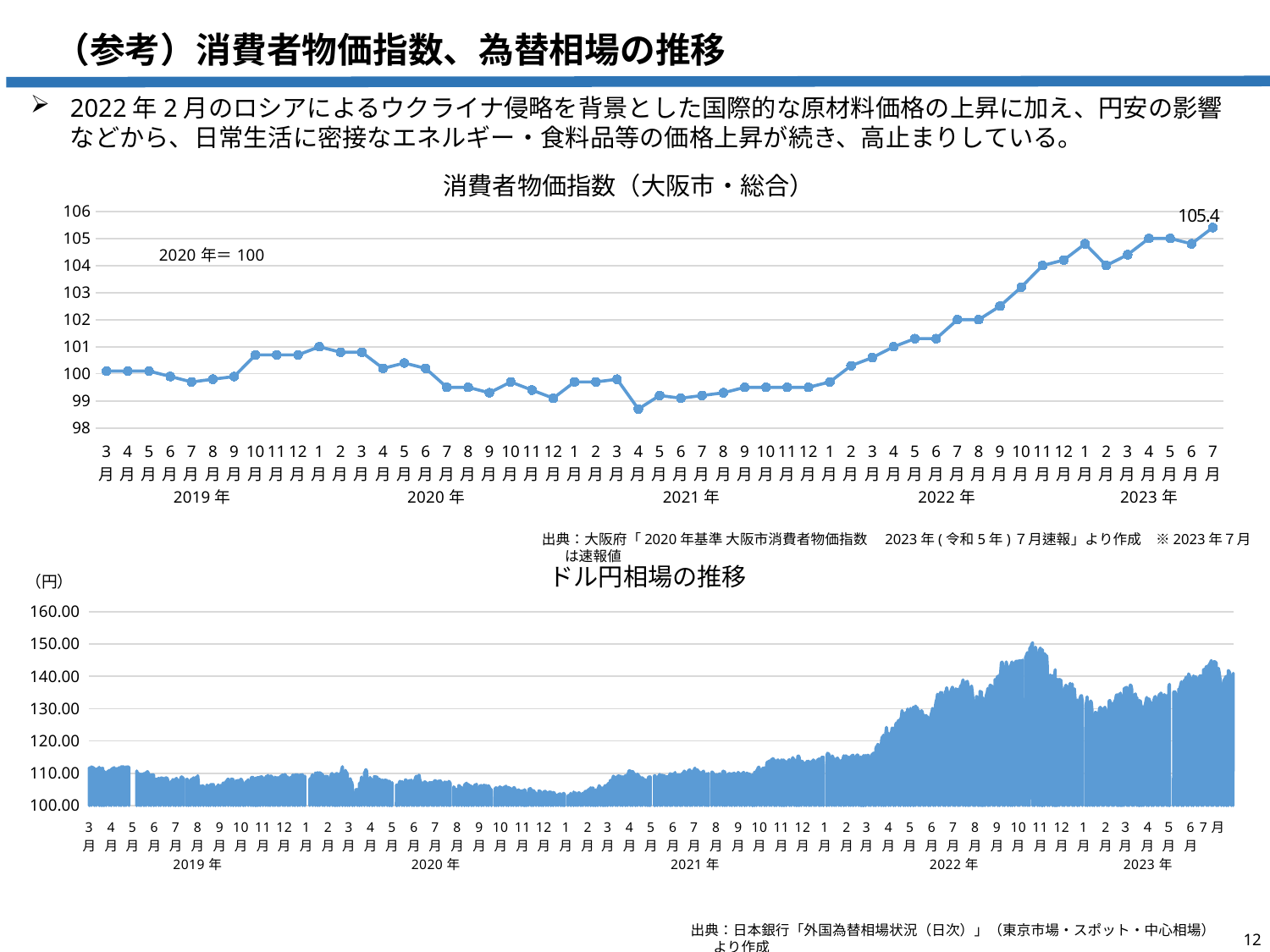
In the 消費者物価指数（大阪市・総合） chart, is the value for 1月 2020年 greater or less than 100? greater In the ドル円相場の推移 chart, is the value around 3月 2019年 greater or less than 120.00? less In the ドル円相場の推移 chart, what unit is shown at the top of the vertical axis? 円 In the 消費者物価指数（大阪市・総合） chart, is the value for 4月 2021年 greater or less than 99? less What kind of chart is the ドル円相場の推移 chart? area chart In the 消費者物価指数（大阪市・総合） chart, which month has the lowest value? 4月 2021年 In the 消費者物価指数（大阪市・総合） chart, which year is set as the base of 100 according to the note on the chart? 2020年 In the 消費者物価指数（大阪市・総合） chart, what is the value labelled for 7月 2023年? 105.4 In the 消費者物価指数（大阪市・総合） chart, which month has the highest value? 7月 2023年 What kind of chart is the 消費者物価指数（大阪市・総合） chart? line chart In the 消費者物価指数（大阪市・総合） chart, do the values rise or fall from 1月 2022年 to 7月 2023年? rise